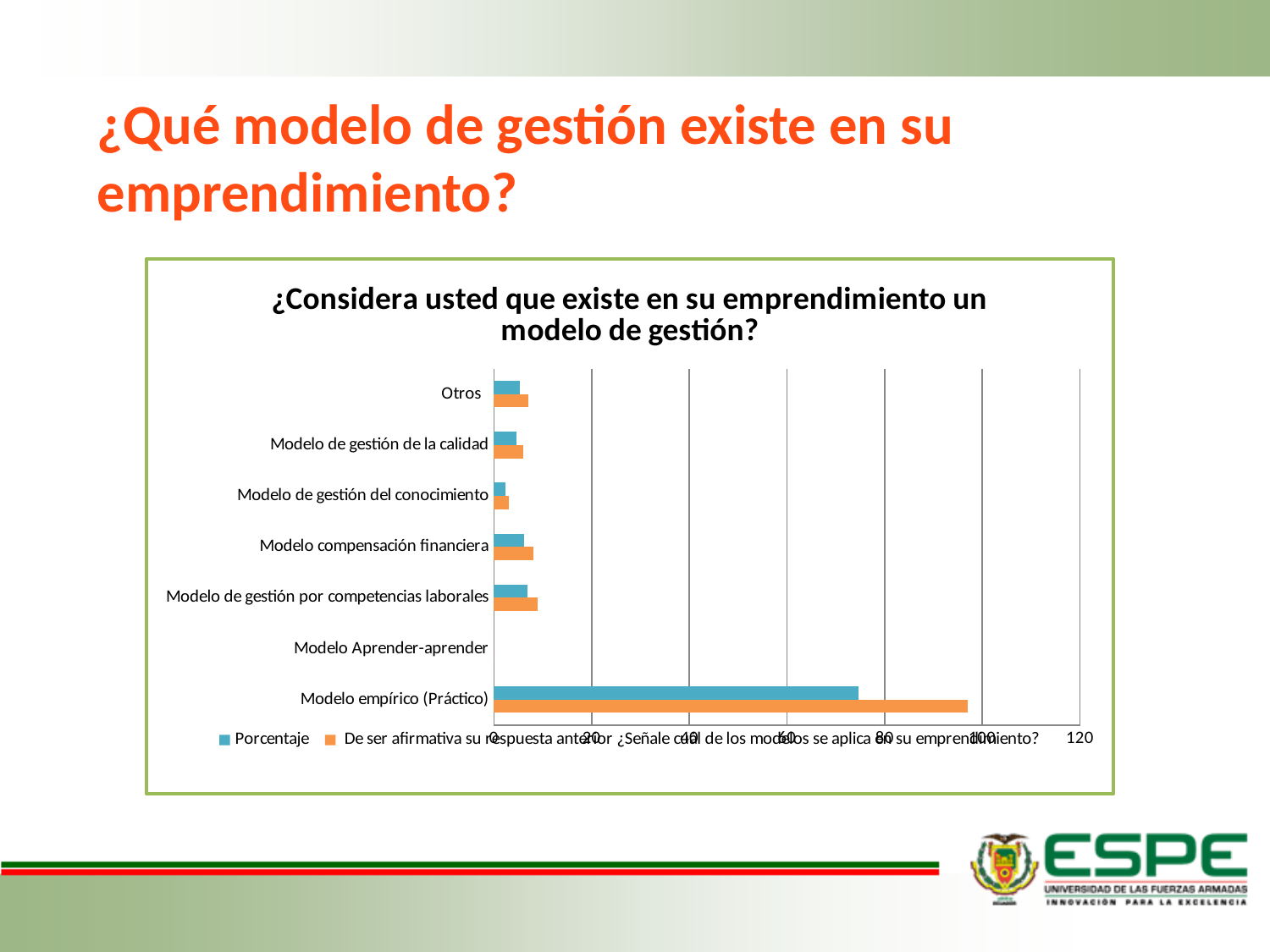
How many categories are plotted on the chart? 7 Which has the larger Porcentaje value, Modelo empírico (Práctico) or Otros? Modelo empírico (Práctico) What is the title of the chart? ¿Considera usted que existe en su emprendimiento un modelo de gestión? Is the Porcentaje value for Otros greater or less than 20? less Is the orange-series value for Modelo empírico (Práctico) greater or less than 80? greater Which category has the lowest Porcentaje value? Modelo Aprender-aprender Is the Porcentaje value for Modelo empírico (Práctico) greater or less than 60? greater For Modelo empírico (Práctico), which series has the larger value, the blue Porcentaje series or the orange series? the orange series How many series does the legend list? 2 Which category has the highest Porcentaje value? Modelo empírico (Práctico) What is the highest value shown on the horizontal axis? 120 What kind of chart is shown on the slide? bar chart